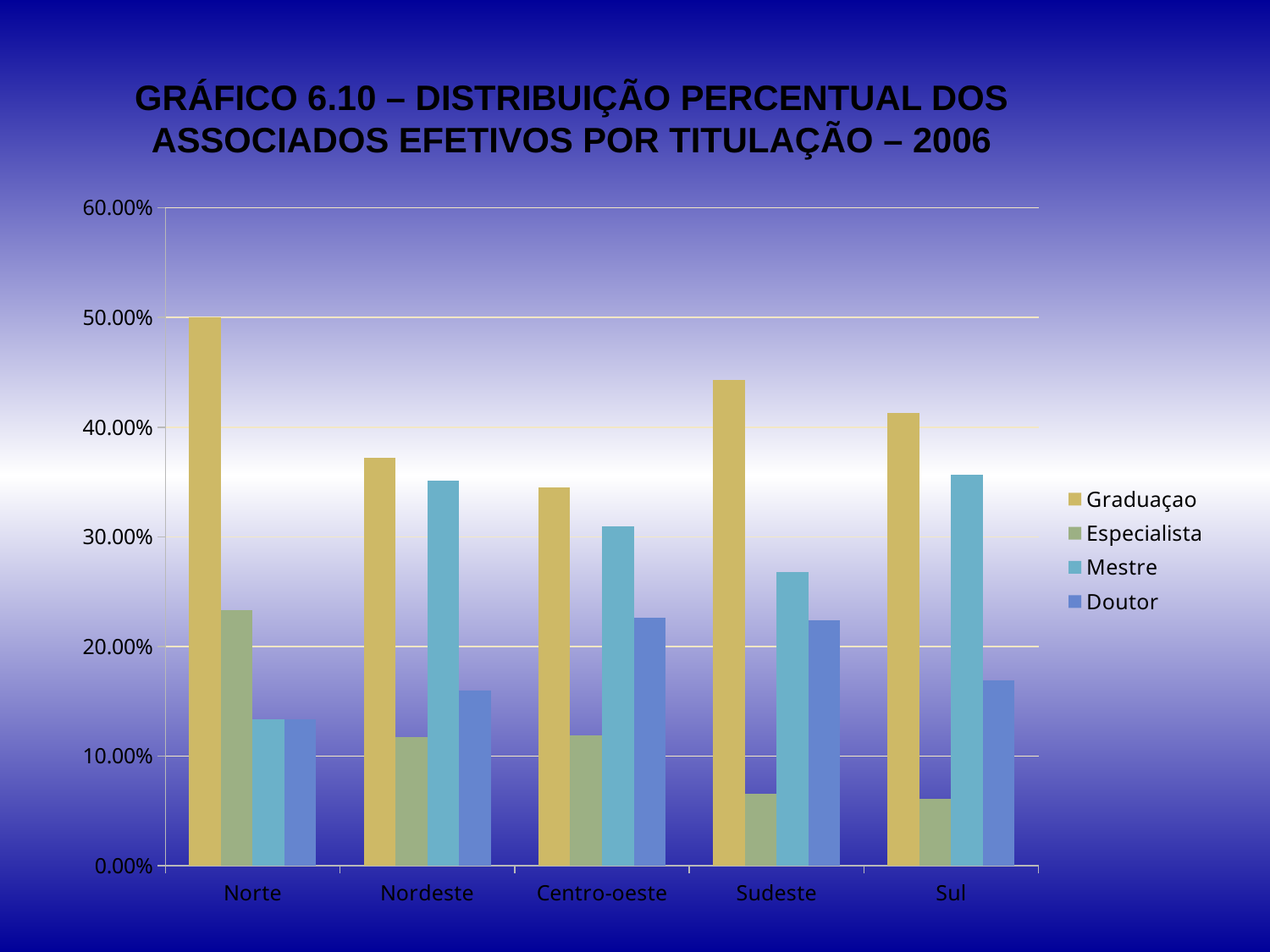
In Sudeste, which is larger: Mestre or Doutor? Mestre Which region has the highest Graduaçao value? Norte What kind of chart is shown on the slide? Bar chart How many series does the legend list? 4 What is the value for Graduaçao in Norte? 50.00% In Nordeste, which is larger: Especialista or Doutor? Doutor How many regions are shown on the x axis? 5 Is the value for Doutor in Nordeste greater or less than 20.00%? less Is the value for Graduaçao in Sudeste greater or less than 40.00%? greater Is the value for Especialista in Sul greater or less than 10.00%? less Which region has the lowest Doutor value? Norte